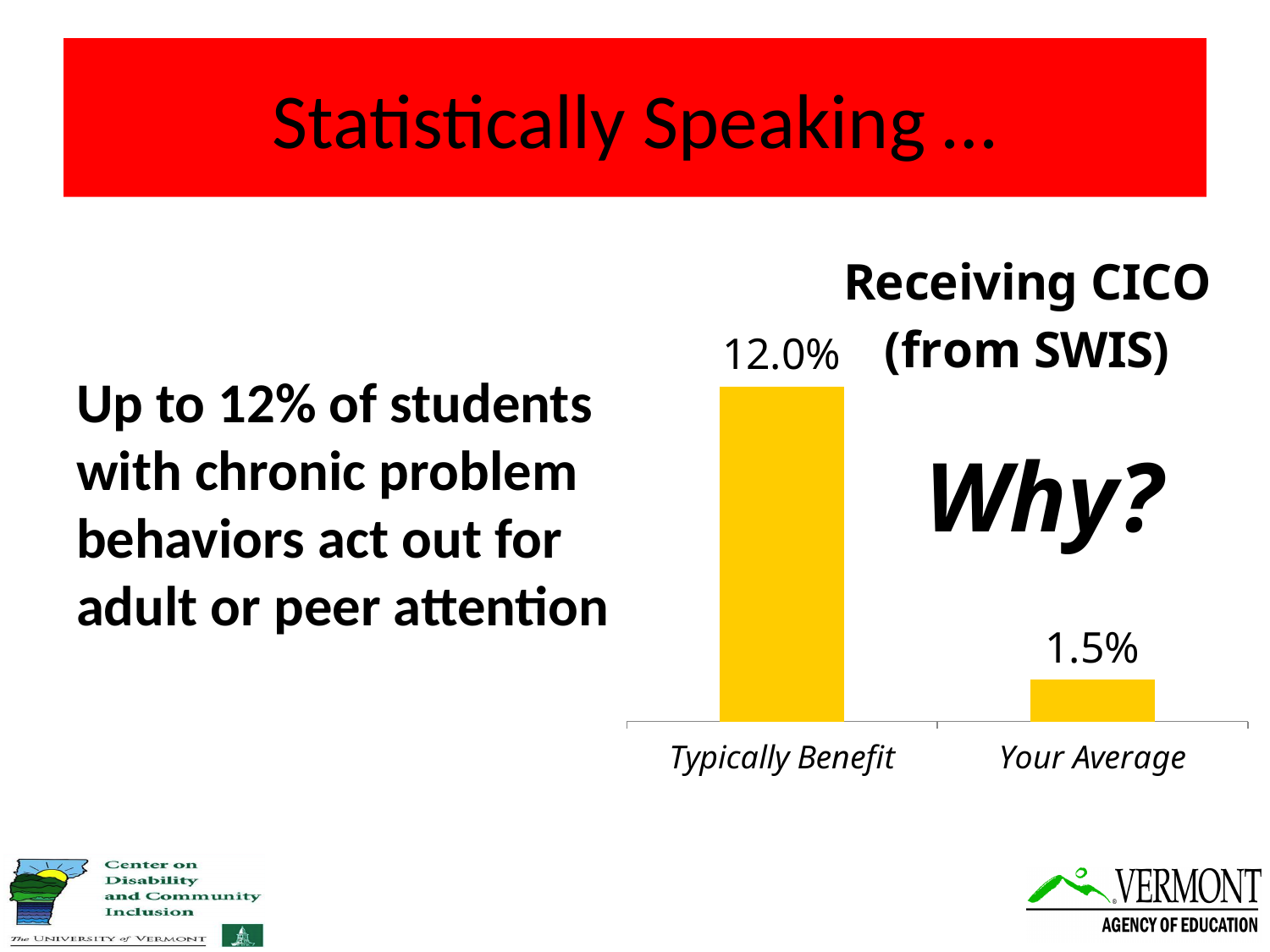
What kind of chart is shown on the slide? Bar chart What is the value for Your Average? 1.5% Do the values rise or fall from Typically Benefit to Your Average? Fall How many categories are shown on the chart? 2 What is the value for Typically Benefit? 12.0% Which is larger, Typically Benefit or Your Average? Typically Benefit Which category has the highest value? Typically Benefit Which category has the lowest value? Your Average What is the title of the chart? Receiving CICO (from SWIS) What colour are the bars in the chart? Yellow What is the difference between the Typically Benefit and Your Average values? 10.5%